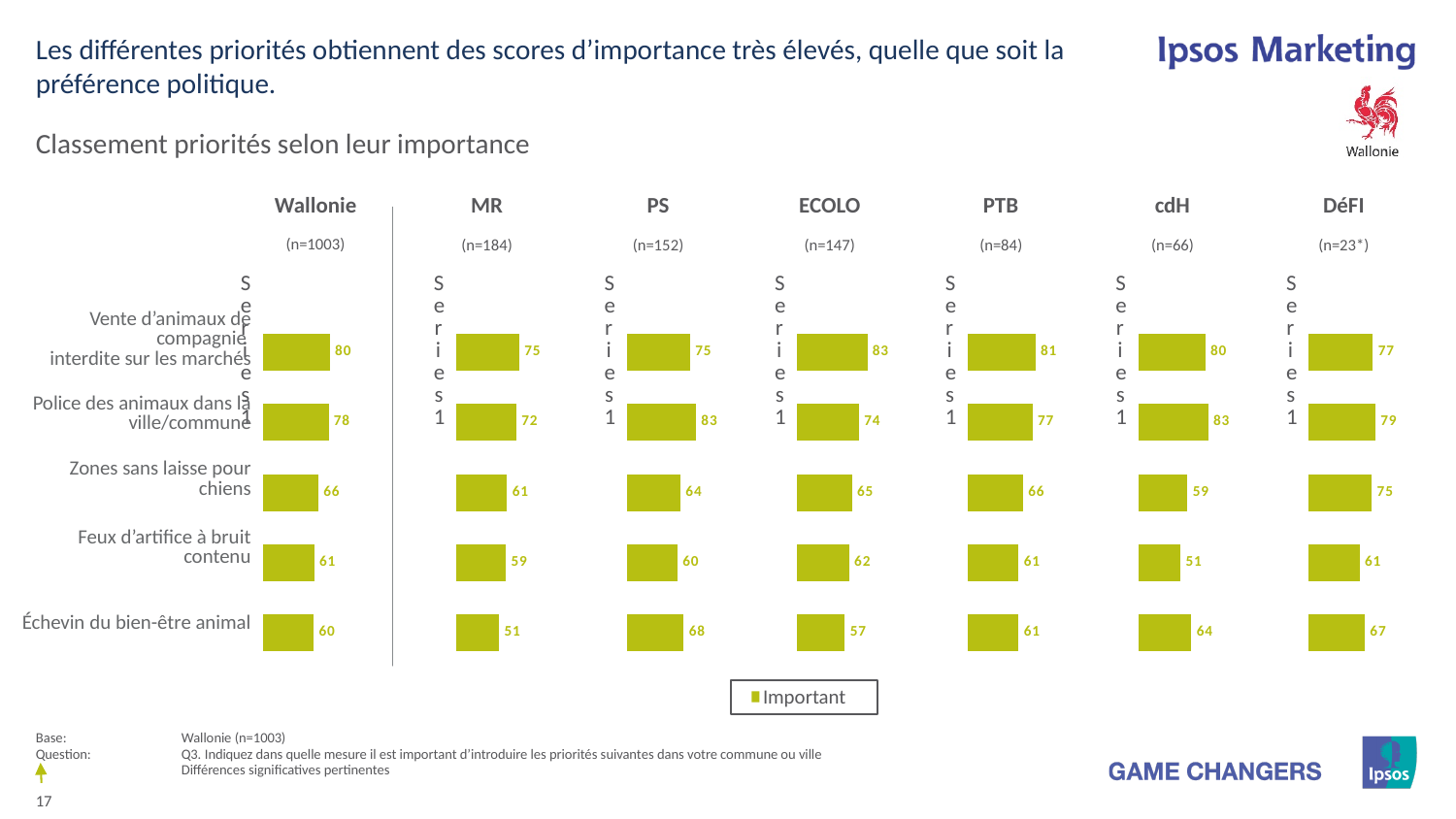
What kind of chart is used for the Wallonie data? bar chart How many series does the legend list? 1 In the DéFI chart, which is larger: the value for "Zones sans laisse pour chiens" or the value for "Échevin du bien-être animal"? Zones sans laisse pour chiens What is the sample size (n) shown for the DéFI chart? n=23* In the Wallonie chart, what is the value for "Vente d'animaux de compagnie interdite sur les marchés"? 80 In the ECOLO chart, which category has the lowest value? Échevin du bien-être animal In the PS chart, which category has the highest value? Police des animaux dans la ville/commune In the ECOLO chart, what is the value for "Vente d'animaux de compagnie interdite sur les marchés"? 83 In the MR chart, what is the value for "Échevin du bien-être animal"? 51 How many categories are shown in the Wallonie chart? 5 In the cdH chart, what is the difference between the values for "Police des animaux dans la ville/commune" and "Feux d'artifice à bruit contenu"? 32 In the PTB chart, what is the value for "Police des animaux dans la ville/commune"? 77